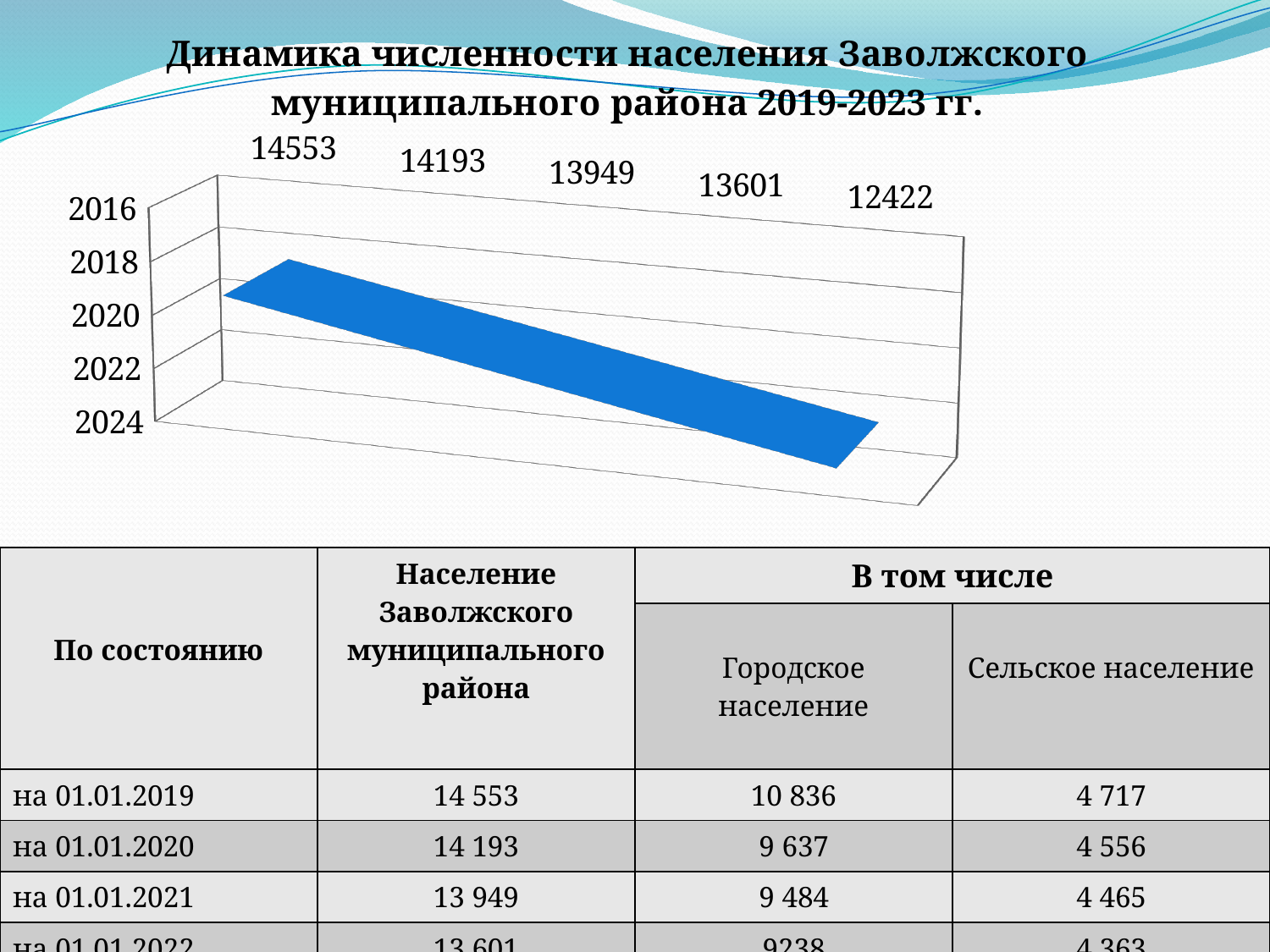
What colour is the plotted series on the chart? blue How many data points are plotted on the chart? 5 Do the values on the chart rise or fall from the first point to the last? fall What is the title of the chart? Динамика численности населения Заволжского муниципального района 2019-2023 гг. What is the difference between the first two data labels on the chart, 14553 and 14193? 360 What is the lowest value shown by the data labels on the chart? 12422 What is the difference between the last two data labels on the chart, 13601 and 12422? 1179 What is the third data label shown on the chart? 13949 Which is larger on the chart: the value labelled 13949 or the value labelled 13601? 13949 What is the difference between the highest and lowest data labels on the chart? 2131 What is the fourth data label shown on the chart? 13601 What is the highest value shown by the data labels on the chart? 14553